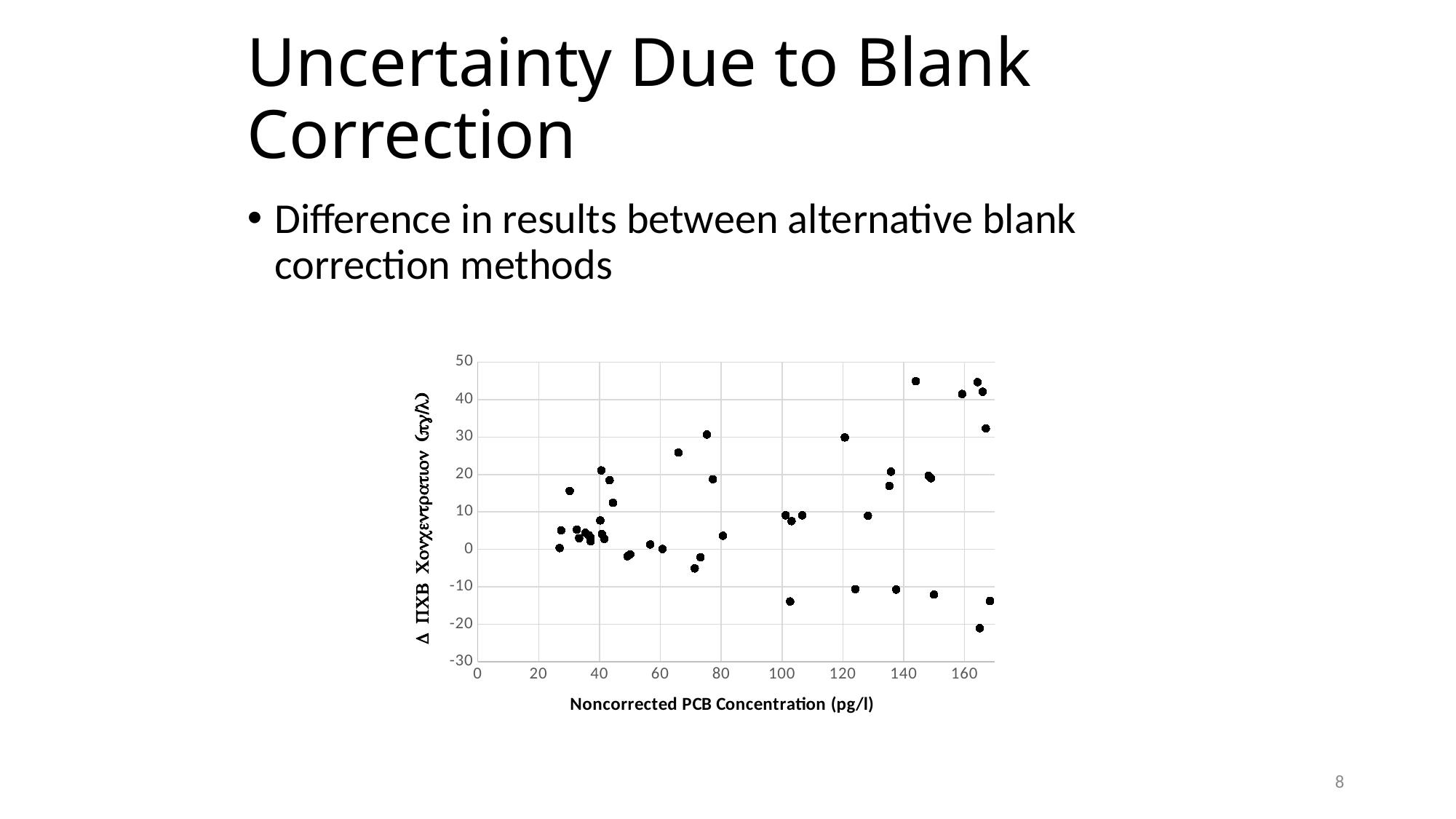
What is the highest tick value shown on the y axis of the chart? 50 What is the title of the x axis of the chart? Noncorrected PCB Concentration (pg/l) Do the largest positive differences on the chart occur at low or high noncorrected PCB concentrations? high Is the lowest plotted y value on the chart greater or less than -10? less Is the highest plotted y value on the chart greater or less than 40? greater Are any of the plotted points on the chart below 0 on the y axis? yes What kind of chart is shown on the slide? scatter plot